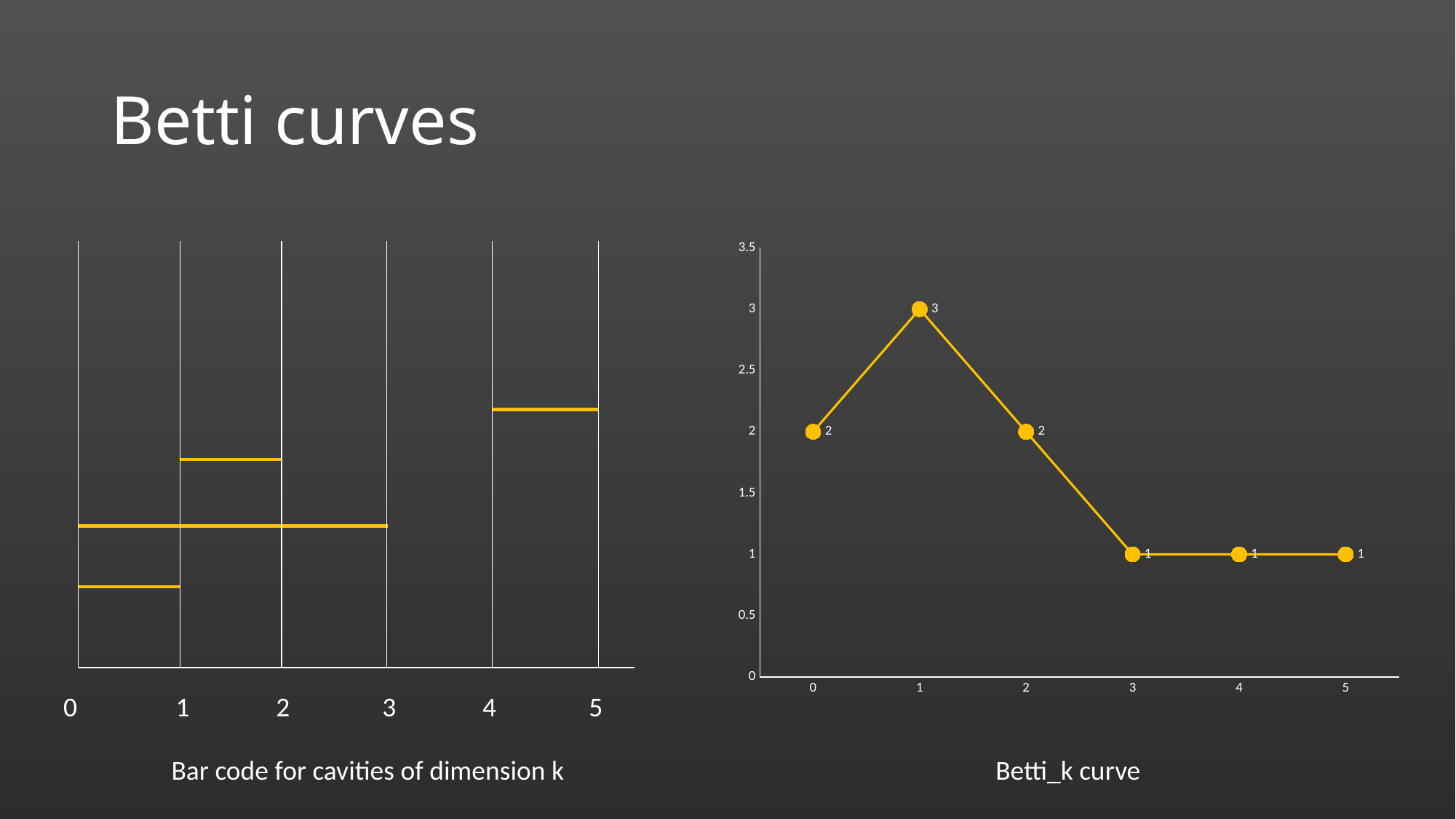
In the Betti_k curve chart, what is the value at x = 3? 1 In the Betti_k curve chart, how many data points are plotted? 6 In the Betti_k curve chart, does the value rise or fall between x = 1 and x = 3? Fall In the Betti_k curve chart, what is the value at x = 0? 2 In the Betti_k curve chart, what is the lowest value plotted? 1 In the Betti_k curve chart, what is the value at x = 5? 1 In the Betti_k curve chart, which is larger: the value at x = 2 or the value at x = 4? x = 2 In the Betti_k curve chart, what is the value at x = 1? 3 In the Betti_k curve chart, at which x value is the curve highest? 1 In the Betti_k curve chart, what is the highest tick label on the y axis? 3.5 What kind of chart is the Betti_k curve chart? Line chart In the Betti_k curve chart, what is the difference between the value at x = 1 and the value at x = 3? 2